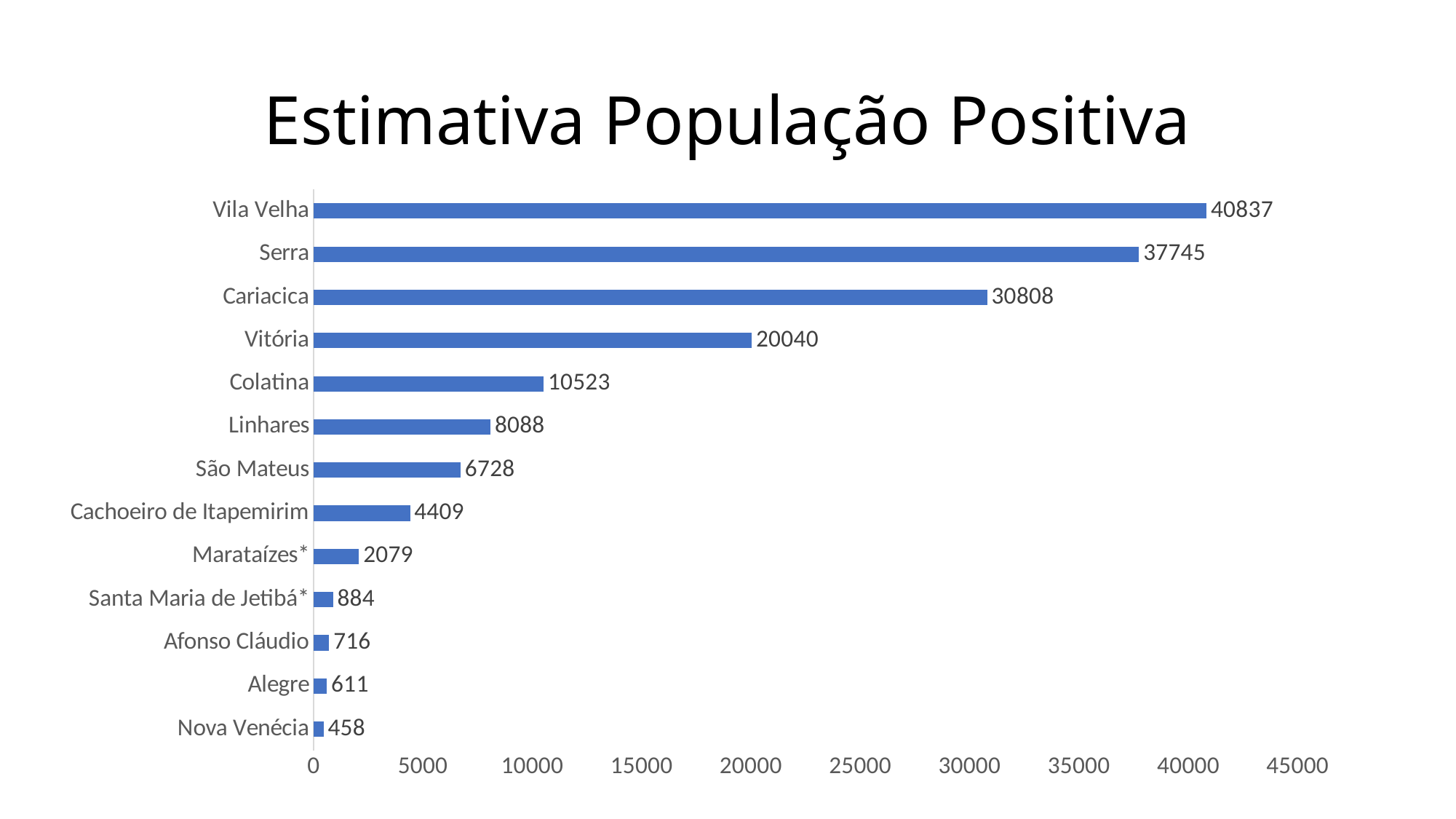
Which is larger, the value for Linhares or the value for São Mateus? Linhares Is the value for Cariacica greater or less than 30000? greater What is the difference between the values for Vila Velha and Serra? 3092 What kind of chart is shown on the slide? bar chart Which category has the lowest value? Nova Venécia What is the title of the chart? Estimativa População Positiva Which category has the highest value? Vila Velha What is the value for Cachoeiro de Itapemirim? 4409 How many categories are shown in the chart? 13 What is the value for Vila Velha? 40837 What is the difference between the values for Vitória and Colatina? 9517 What is the value for Colatina? 10523